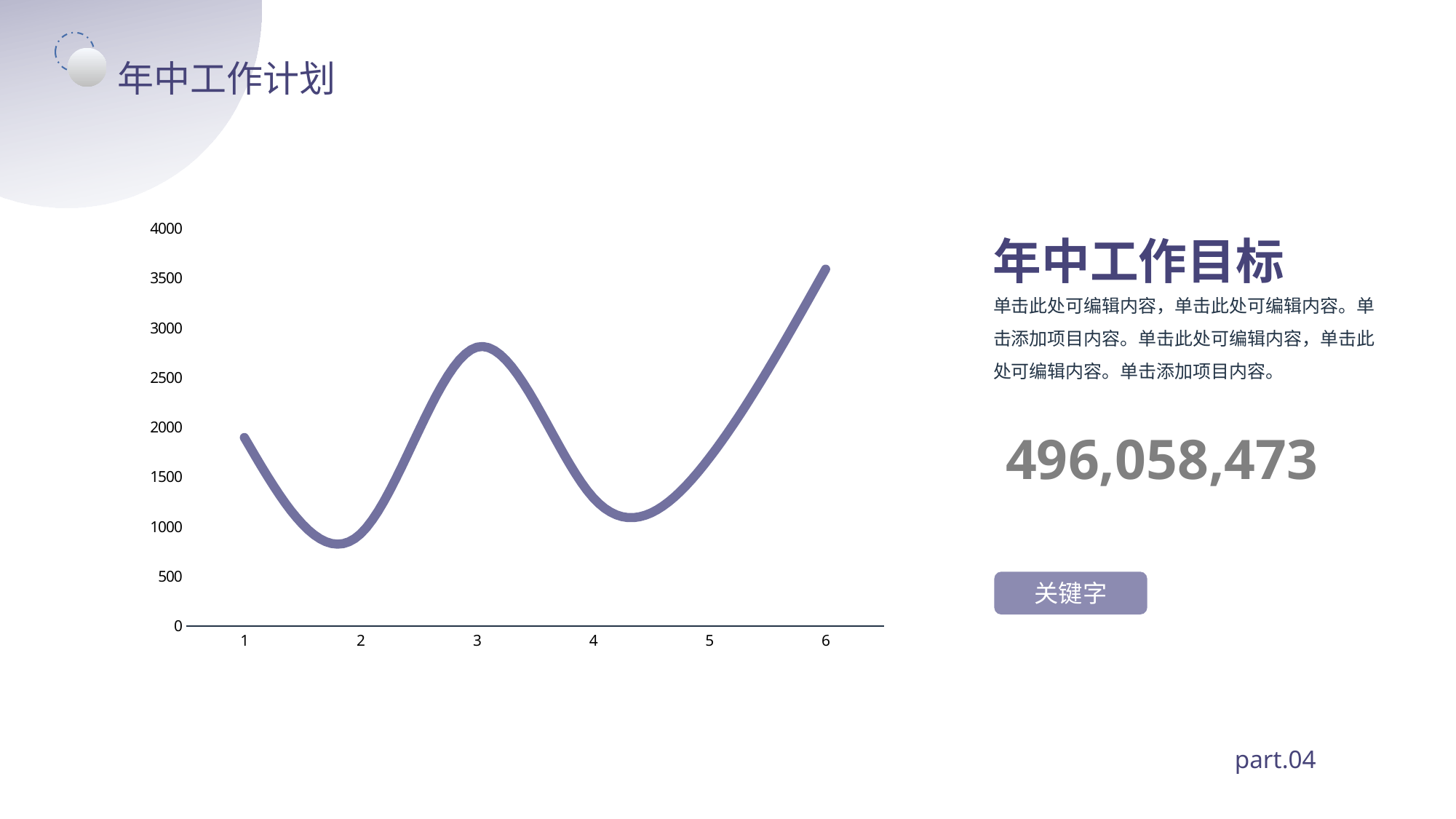
Which has the larger value, category 3 or category 6? 6 Does the line rise or fall from category 4 to category 6? rise What is the highest tick value shown on the y axis? 4000 What kind of chart is shown on the slide? line chart Is the value at category 6 greater or less than 3000? greater At which x-axis category does the line reach its highest value? 6 Is the value at category 1 greater or less than 1500? greater Is the value at category 5 greater or less than 1500? greater How many points are plotted along the x axis of the line chart? 6 Which has the larger value, category 1 or category 4? 1 At which x-axis category does the line reach its lowest value? 2